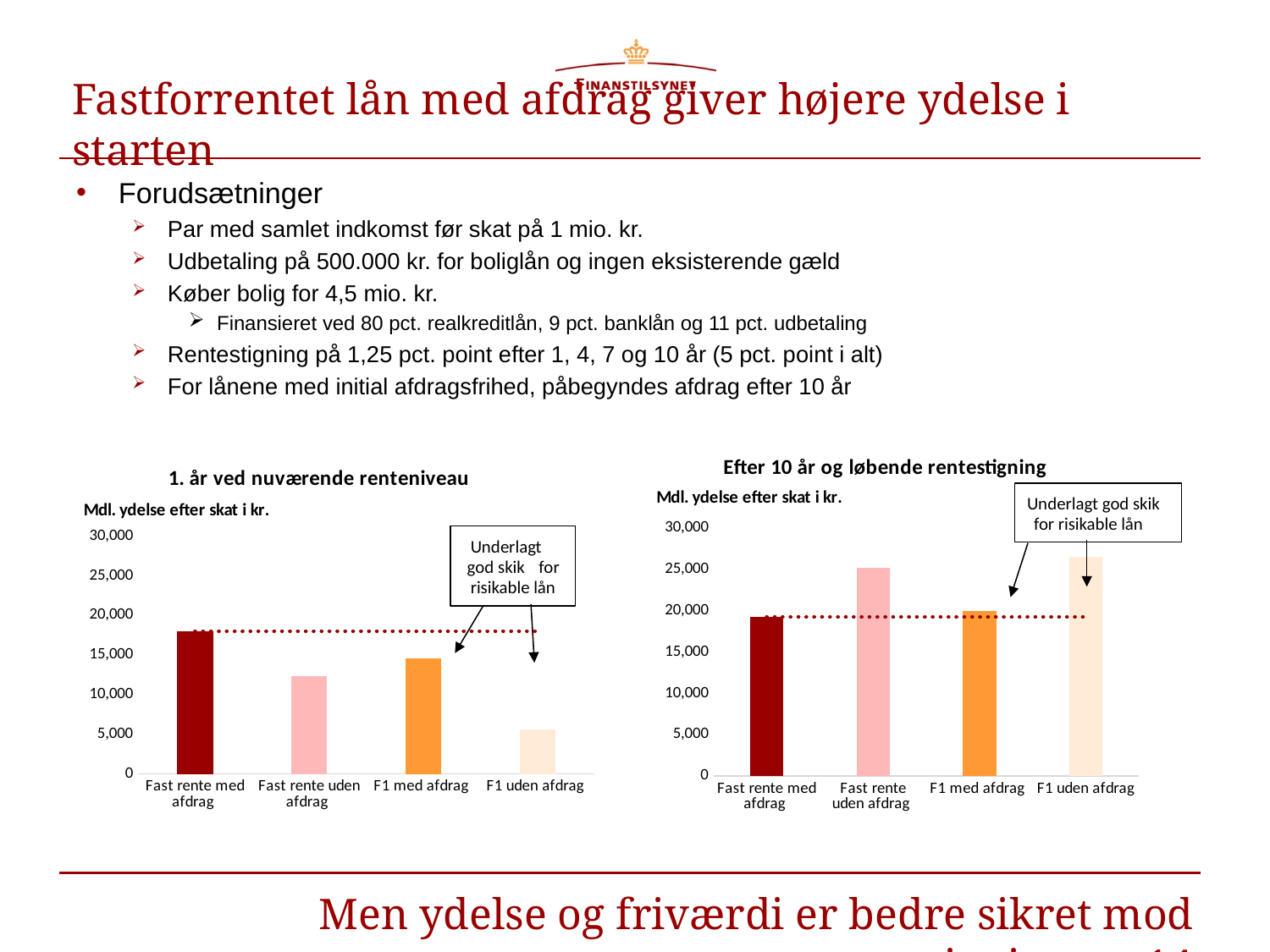
How many categories are shown on the x axis of the left chart "1. år ved nuværende renteniveau"? 4 In the right chart "Efter 10 år og løbende rentestigning", which category has the lowest value? Fast rente med afdrag In the left chart "1. år ved nuværende renteniveau", which category has the lowest value? F1 uden afdrag In the left chart "1. år ved nuværende renteniveau", is the value for F1 uden afdrag greater or less than 10,000? less In the left chart "1. år ved nuværende renteniveau", is the value for Fast rente med afdrag greater or less than 15,000? greater In the right chart "Efter 10 år og løbende rentestigning", is the value for Fast rente uden afdrag greater or less than 20,000? greater In the left chart "1. år ved nuværende renteniveau", which is larger: F1 med afdrag or Fast rente uden afdrag? F1 med afdrag In the right chart "Efter 10 år og løbende rentestigning", which is larger: Fast rente uden afdrag or F1 med afdrag? Fast rente uden afdrag What is the y-axis label shown on the right chart "Efter 10 år og løbende rentestigning"? Mdl. ydelse efter skat i kr. In the left chart "1. år ved nuværende renteniveau", which category has the highest value? Fast rente med afdrag In the right chart "Efter 10 år og løbende rentestigning", which category has the highest value? F1 uden afdrag What kind of chart is the left chart titled "1. år ved nuværende renteniveau"? bar chart